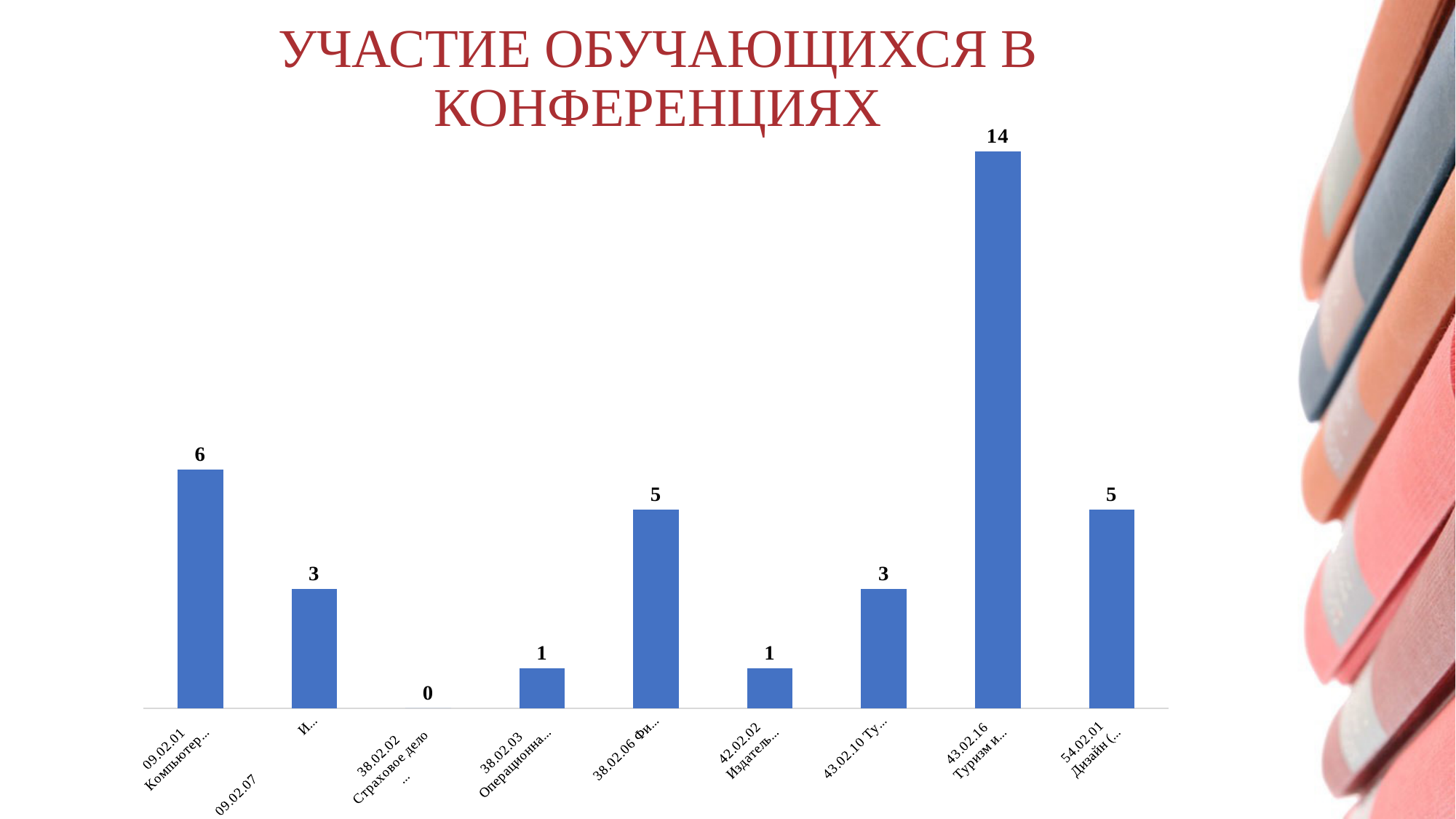
How many categories are shown in the chart? 9 What is the title of the slide? УЧАСТИЕ ОБУЧАЮЩИХСЯ В КОНФЕРЕНЦИЯХ Which category has the highest value? 43.02.16 What is the value for the category 43.02.16? 14 What is the value for the category 54.02.01 (Дизайн)? 5 What is the value for the category 38.02.02 (Страховое дело)? 0 What kind of chart is shown on the slide? bar chart What is the difference between the values for 43.02.16 and 09.02.01? 8 Which category has the lowest value? 38.02.02 What colour are the bars in the chart? blue Which is larger, the value for 09.02.07 or the value for 38.02.06? 38.02.06 What is the value for the category 09.02.01? 6